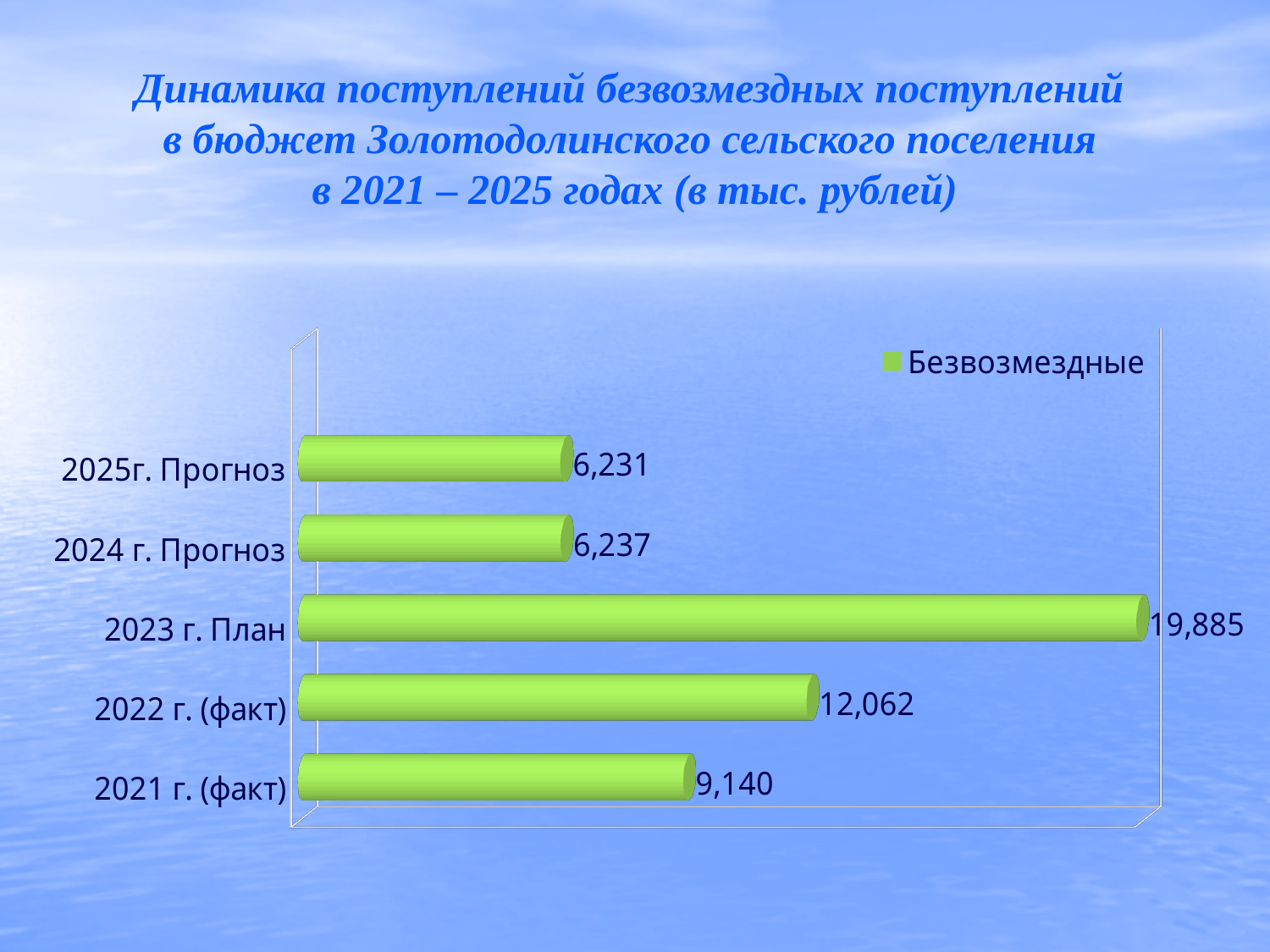
What is the difference between the values for 2022 г. (факт) and 2021 г. (факт)? 2,922 Which category has the highest value? 2023 г. План What kind of chart is shown on the slide? Bar chart What series name does the legend show? Безвозмездные What is the difference between the values for 2023 г. План and 2022 г. (факт)? 7,823 What is the value for 2022 г. (факт)? 12,062 What is the value for 2023 г. План? 19,885 What is the value for 2021 г. (факт)? 9,140 What is the value for 2025г. Прогноз? 6,231 Which is larger, the value for 2022 г. (факт) or the value for 2021 г. (факт)? 2022 г. (факт) What is the value for 2024 г. Прогноз? 6,237 How many categories are shown in the chart? 5